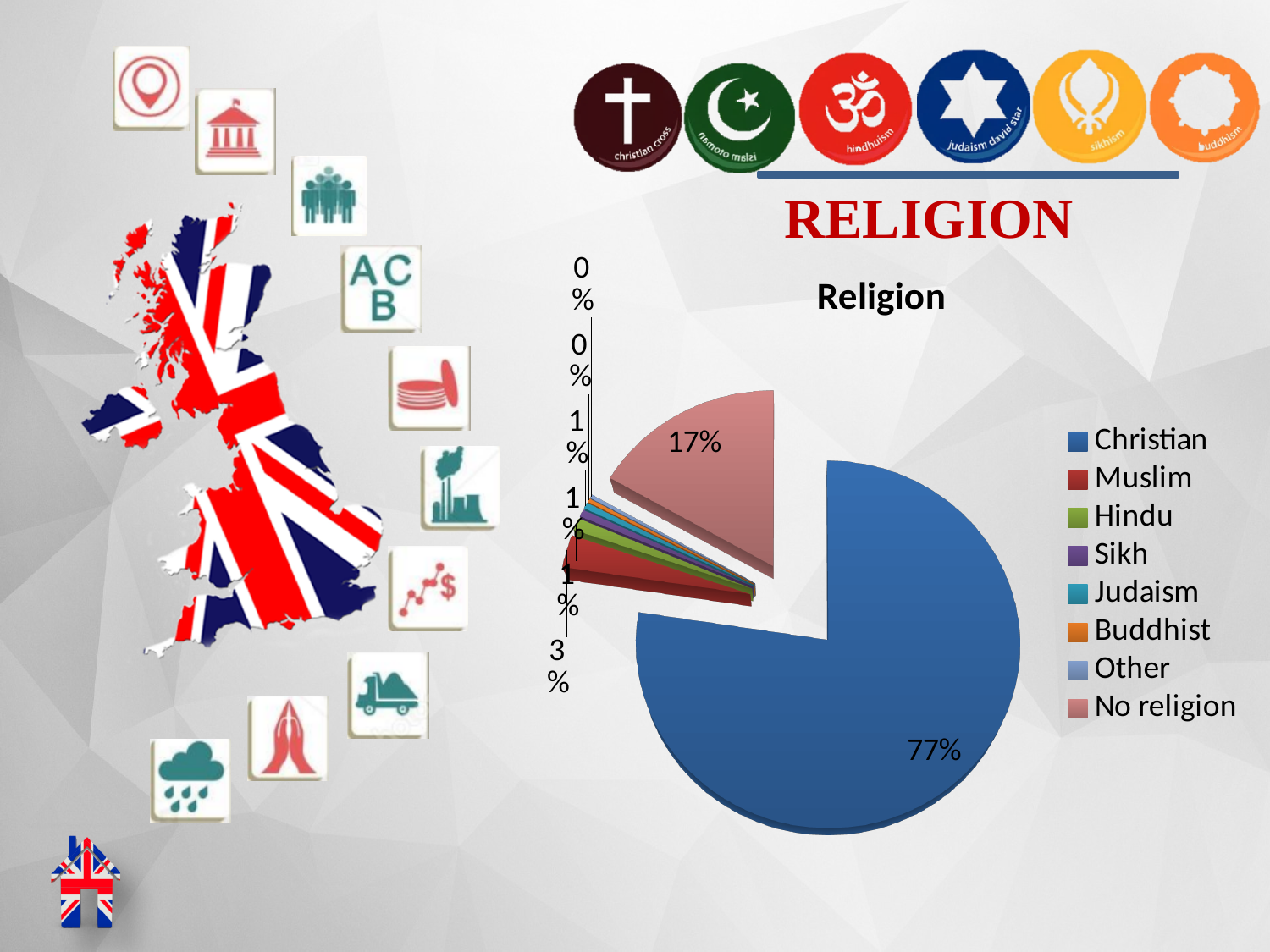
Which is larger, the Christian slice or the No religion slice? Christian Which category has the largest slice of the pie? Christian What is the value shown for the Christian slice? 77% What colour is the Christian slice in the pie chart? blue What share of the pie does the No religion slice represent? 17% What kind of chart is shown on the slide? pie chart What is the difference between the Christian and No religion values? 60 percentage points How many categories does the legend list? 8 What is the value shown for the No religion slice? 17% What is the title of the chart? Religion